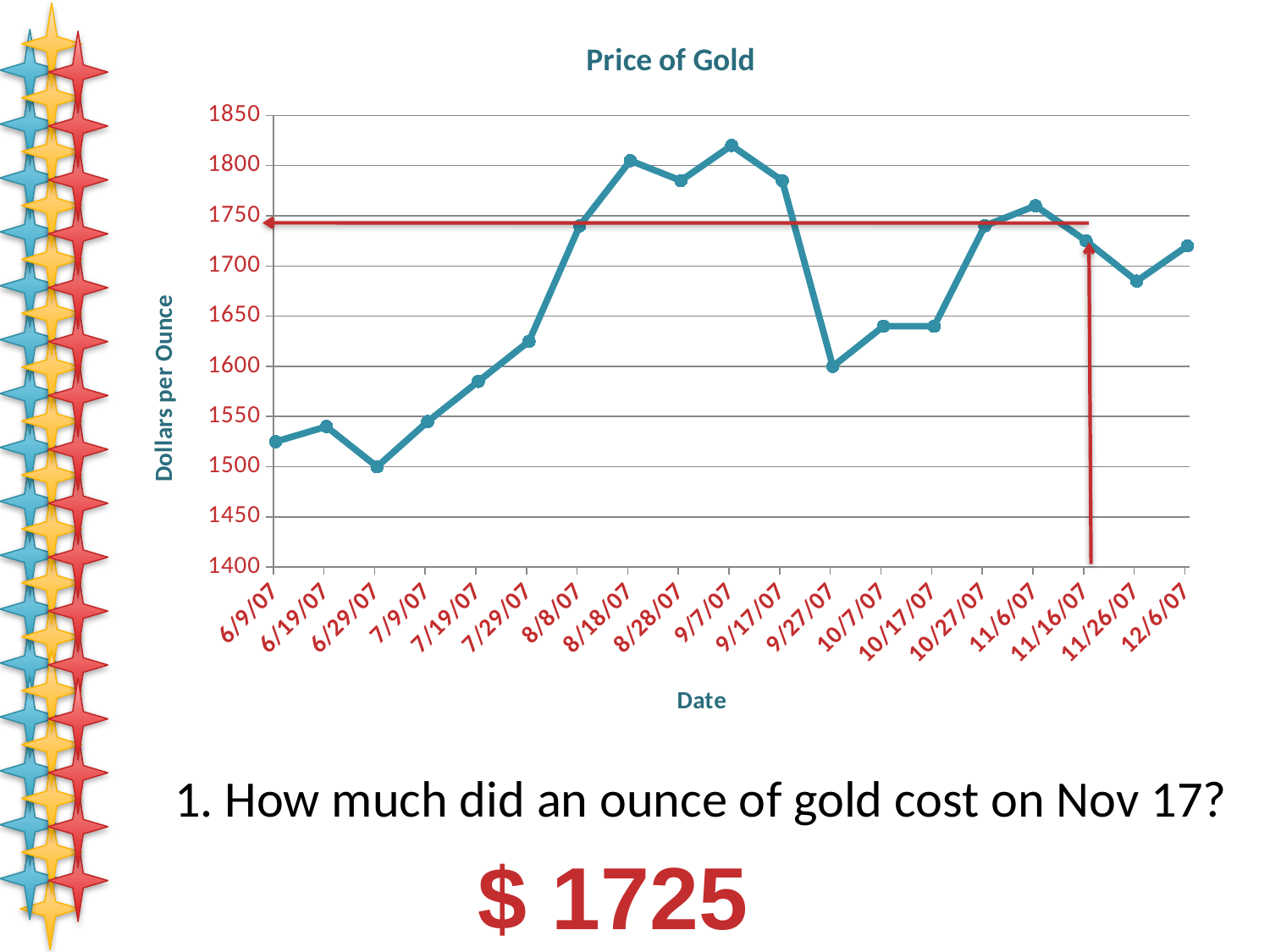
What is the price of gold on 9/27/07? 1600 On which date is the price of gold highest? 9/7/07 How many data points are plotted on the line? 19 What is the title of the chart? Price of Gold What kind of chart is shown on the slide? line chart What is the label of the vertical axis? Dollars per Ounce Which date has a higher price of gold, 9/27/07 or 10/7/07? 10/7/07 Is the price of gold on 11/26/07 greater or less than 1700? less What is the price of gold on 6/29/07? 1500 According to the slide, how much did an ounce of gold cost on Nov 17? $ 1725 On which date is the price of gold lowest? 6/29/07